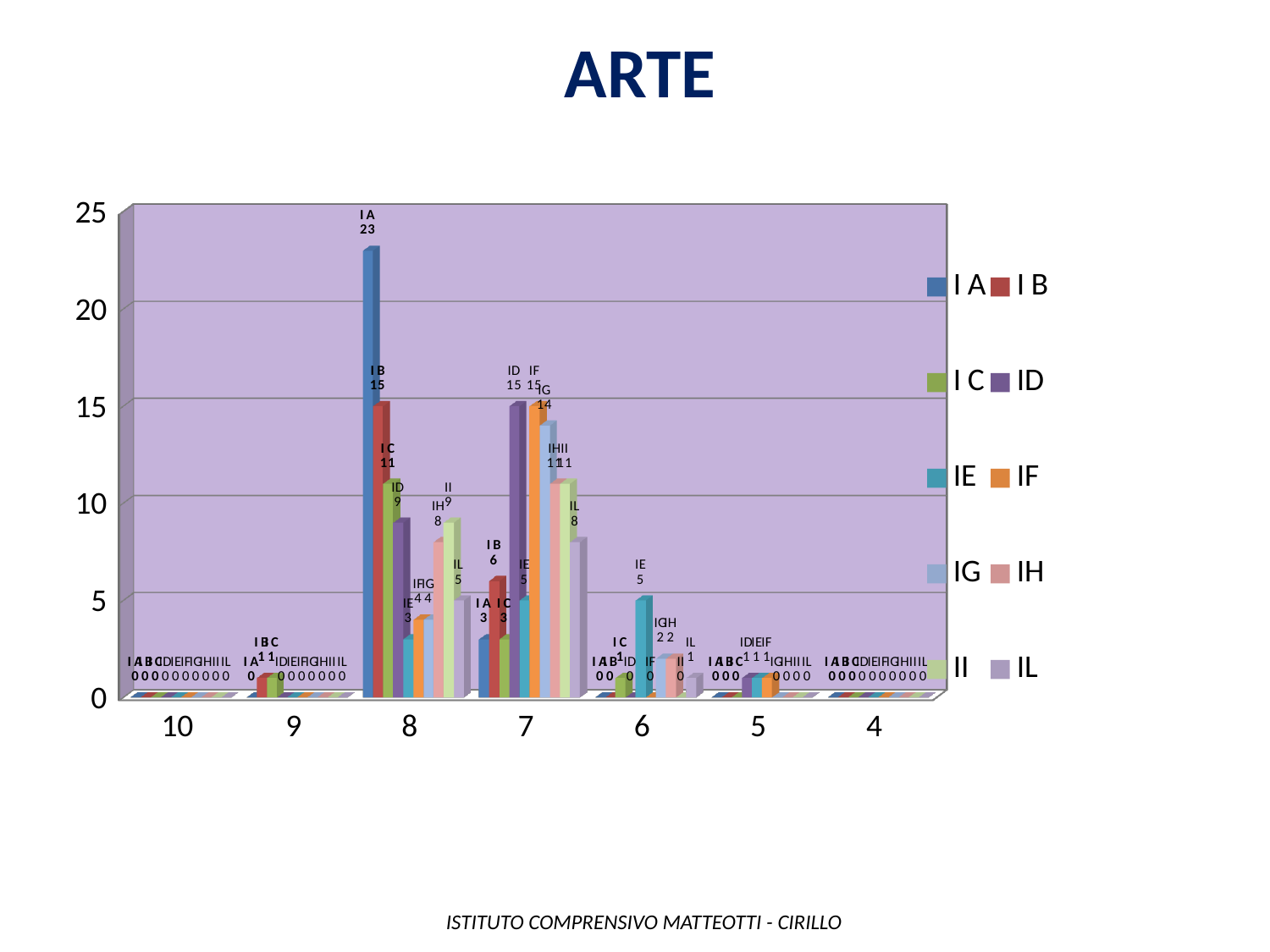
What is the value for series IE in category 6? 5 What is the title of the chart? ARTE Is the value for I A in category 8 greater or less than 20? greater What is the value for series I A in category 8? 23 Which series has the highest value in category 8? I A What kind of chart is shown on the slide? bar chart What is the value for series IG in category 7? 14 What is the difference between the I A value and the I B value in category 8? 8 How many categories are shown on the x axis? 7 How many series does the legend list? 10 Is the ID value larger in category 7 or in category 8? 7 What is the value for series IL in category 7? 8